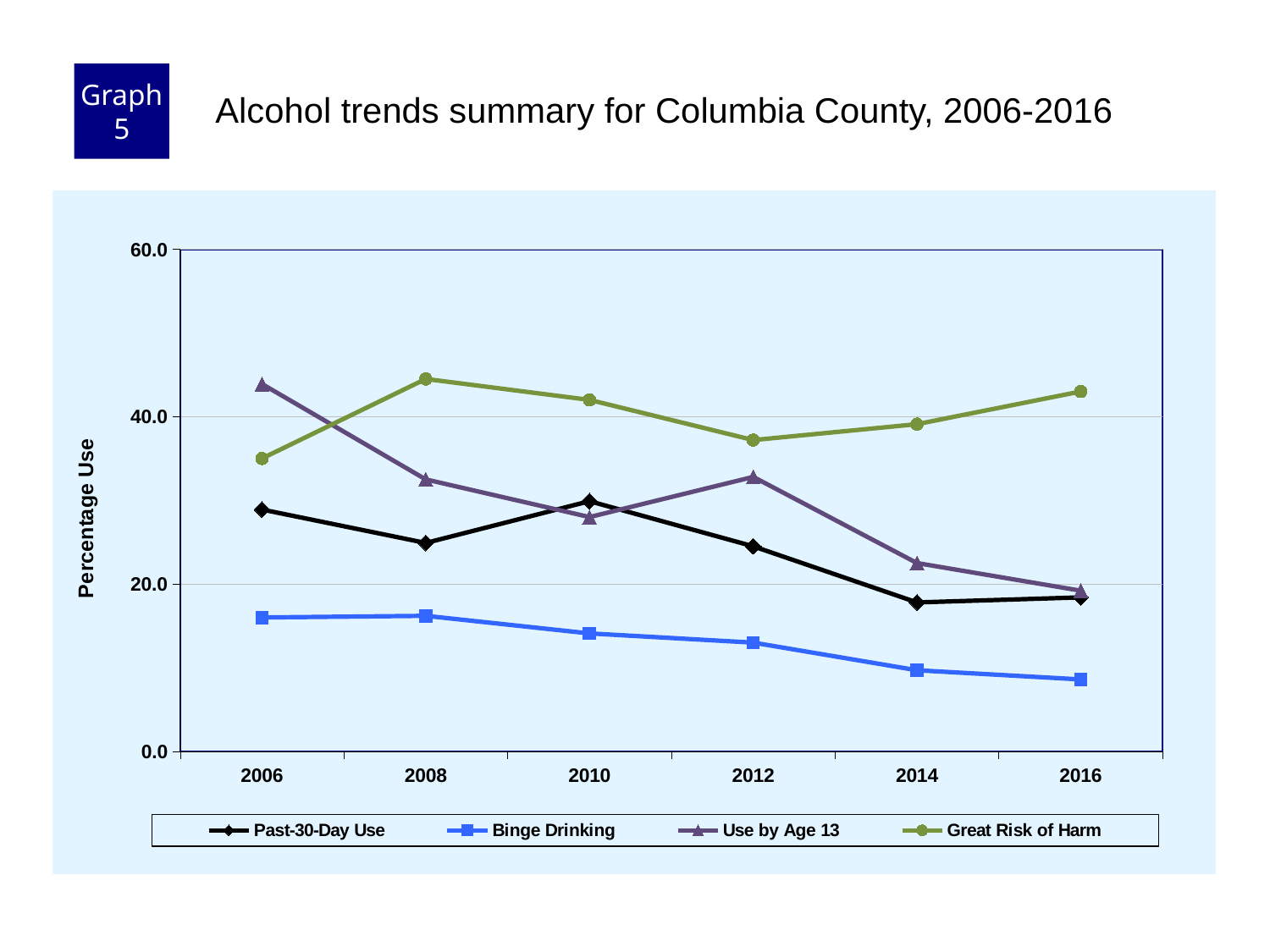
Which series has the highest value in 2016? Great Risk of Harm How many series does the legend list? 4 What is the label on the y axis? Percentage Use What kind of chart is shown on the slide? Line chart How many years are plotted along the x axis? 6 Is the value for Great Risk of Harm in 2012 greater or less than 40.0? less In 2006, which is larger: Use by Age 13 or Great Risk of Harm? Use by Age 13 Is the value for Binge Drinking in 2006 greater or less than 20.0? less Is the value for Great Risk of Harm in 2008 greater or less than 40.0? greater Which series has the lowest value in 2012? Binge Drinking Does the Binge Drinking line rise or fall from 2006 to 2016? Fall